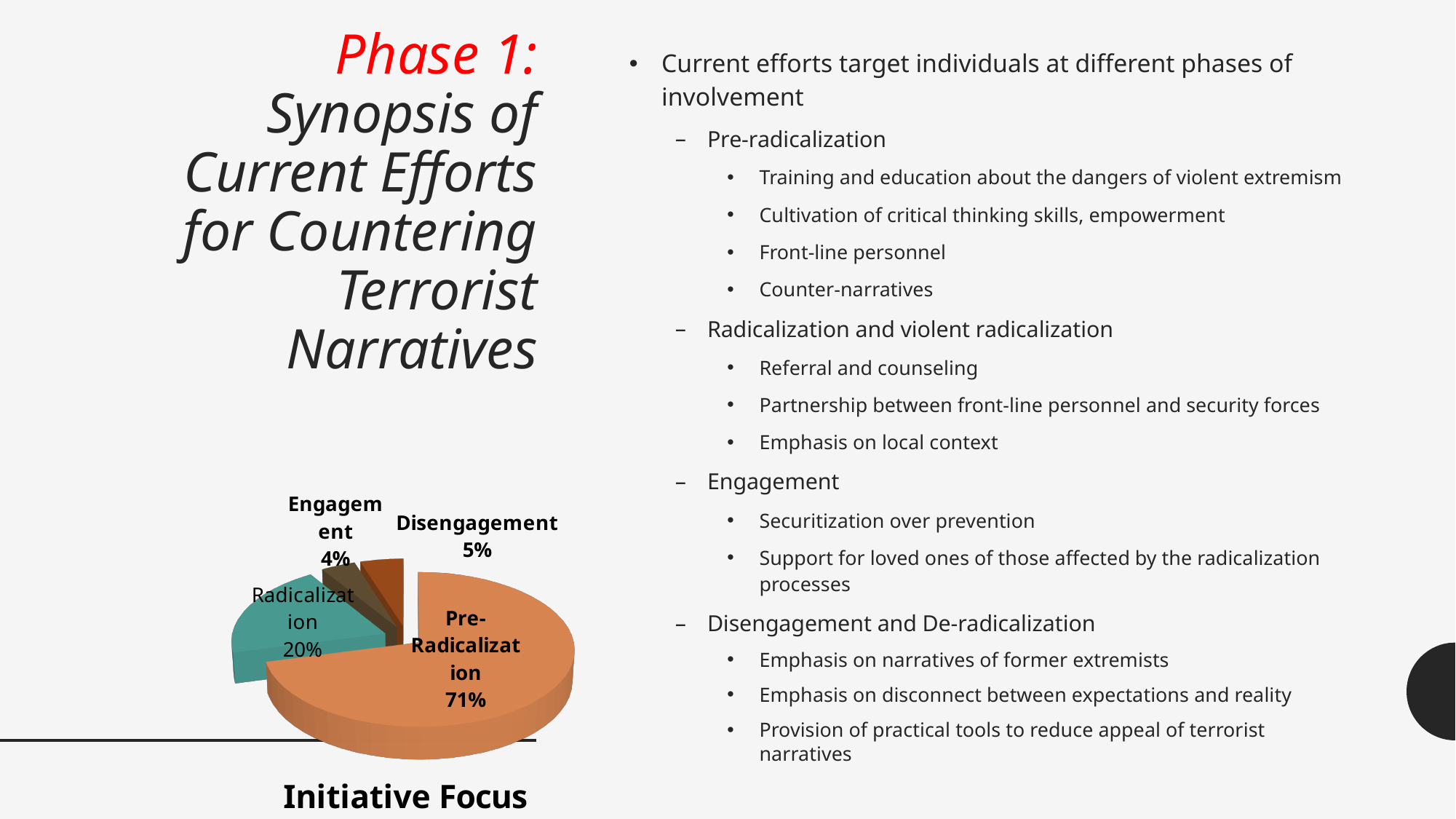
What share of the pie does Pre-Radicalization have? 71% What is the difference in percentage points between Pre-Radicalization and Radicalization? 51 Which category has the smallest slice of the pie? Engagement How many categories are shown in the pie chart? 4 What is the title of the chart? Initiative Focus What share of the pie does Engagement have? 4% Which category has the largest slice of the pie? Pre-Radicalization What kind of chart is shown on the slide? Pie chart What share of the pie does Disengagement have? 5% Which is larger, the share for Disengagement or the share for Engagement? Disengagement What share of the pie does Radicalization have? 20% What is the combined share of Engagement and Disengagement? 9%